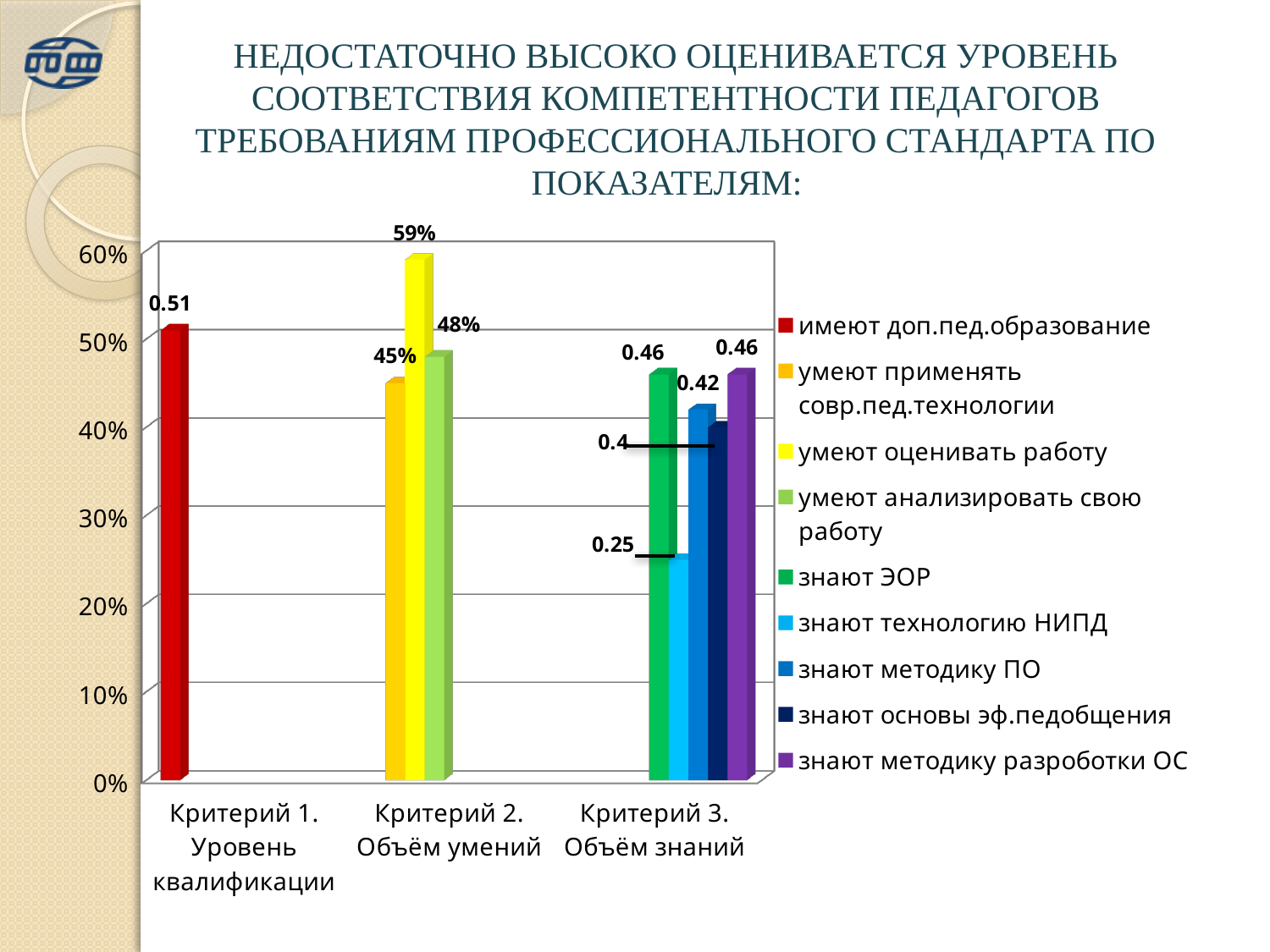
What is the value for "умеют оценивать работу" in Критерий 2? 59% Which series has the highest bar on the chart? умеют оценивать работу What kind of chart is shown on the slide? bar chart How many categories (критерии) are shown on the x axis? 3 What is the difference between the values for "знают ЭОР" and "знают технологию НИПД"? 0.21 What is the value for "умеют анализировать свою работу"? 48% Which is larger: the value for "знают методику ПО" or for "знают основы эф.педобщения"? знают методику ПО What is the value for "имеют доп.пед.образование" in Критерий 1? 0.51 What is the value for "знают технологию НИПД" in Критерий 3? 0.25 Which series has the lowest bar on the chart? знают технологию НИПД How many series does the legend list? 9 What colour represents "знают методику разработки ОС" in the legend? purple